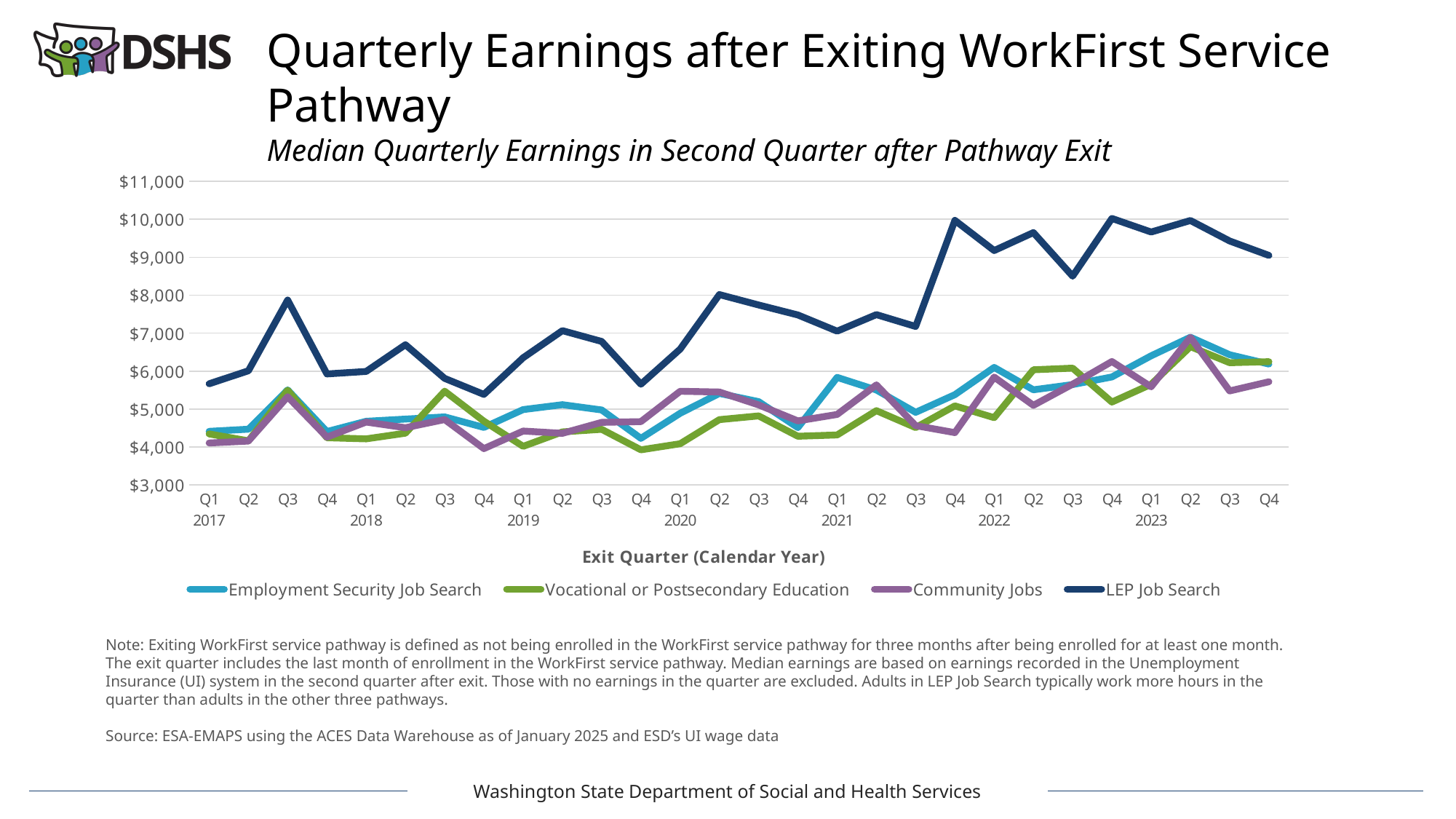
Is the value for Employment Security Job Search in Q1 2021 greater or less than $5,000? greater Is the value for LEP Job Search in Q1 2017 greater or less than $6,000? less Which series has the highest median quarterly earnings across the whole period? LEP Job Search What kind of chart is shown on the slide? Line chart What is the label of the x axis? Exit Quarter (Calendar Year) How many series does the legend list? 4 Is the value for LEP Job Search in Q3 2022 greater or less than $9,000? less In Q4 2023, which is larger: LEP Job Search or Employment Security Job Search? LEP Job Search Does the LEP Job Search line generally rise or fall from 2017 to 2023? Rise How many exit quarters are plotted along the x axis? 28